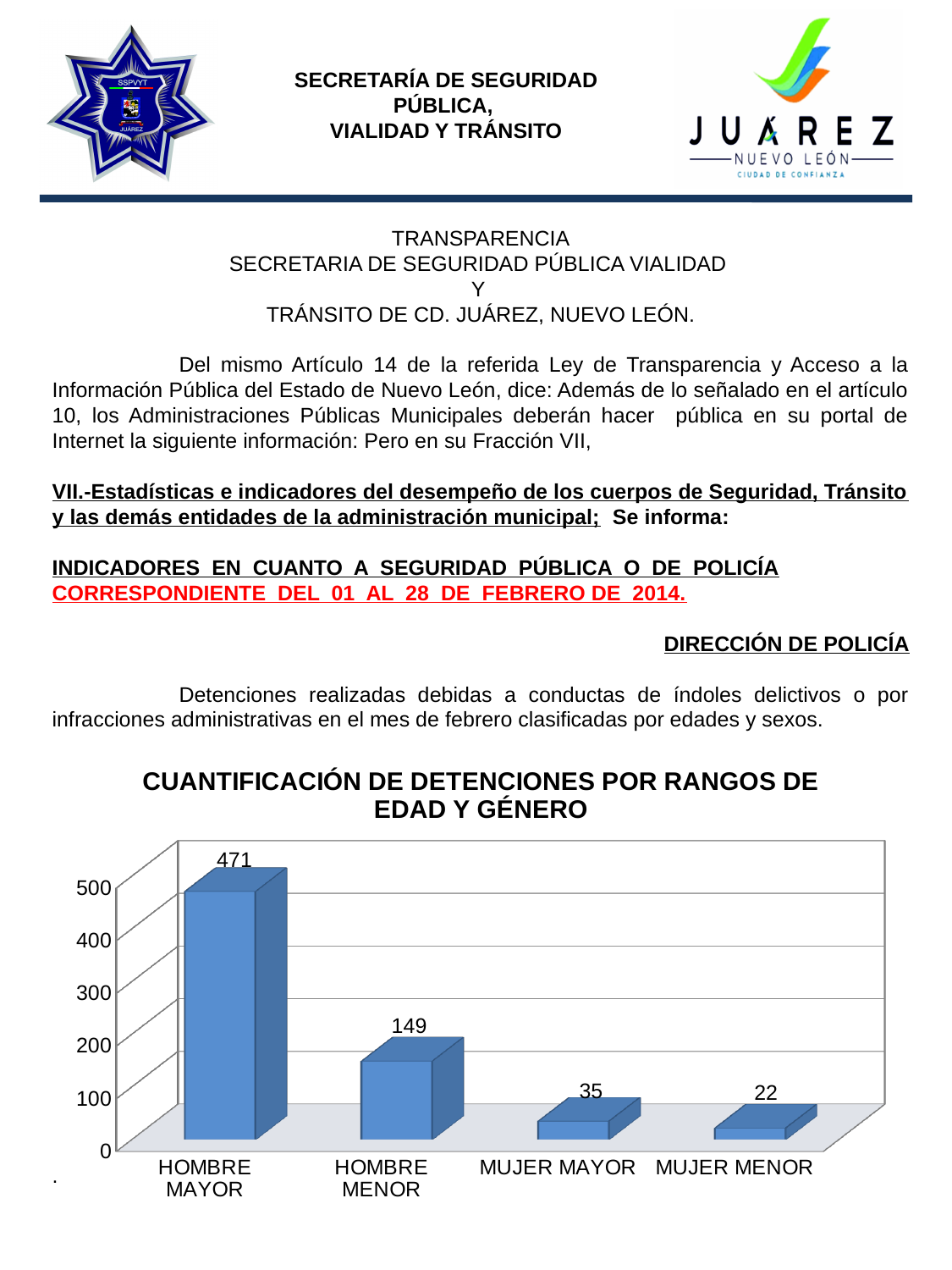
How many categories are shown on the chart? 4 Which category has the highest value? HOMBRE MAYOR What is the title of the chart? CUANTIFICACIÓN DE DETENCIONES POR RANGOS DE EDAD Y GÉNERO Is the value for HOMBRE MENOR greater or less than 200? less What is the value for MUJER MENOR? 22 What is the difference between the values for MUJER MAYOR and MUJER MENOR? 13 Which is larger, the value for HOMBRE MENOR or the value for MUJER MAYOR? HOMBRE MENOR What is the difference between the values for HOMBRE MAYOR and HOMBRE MENOR? 322 What kind of chart is shown on the slide? bar chart Which category has the lowest value? MUJER MENOR What is the value for HOMBRE MAYOR? 471 What is the value for HOMBRE MENOR? 149